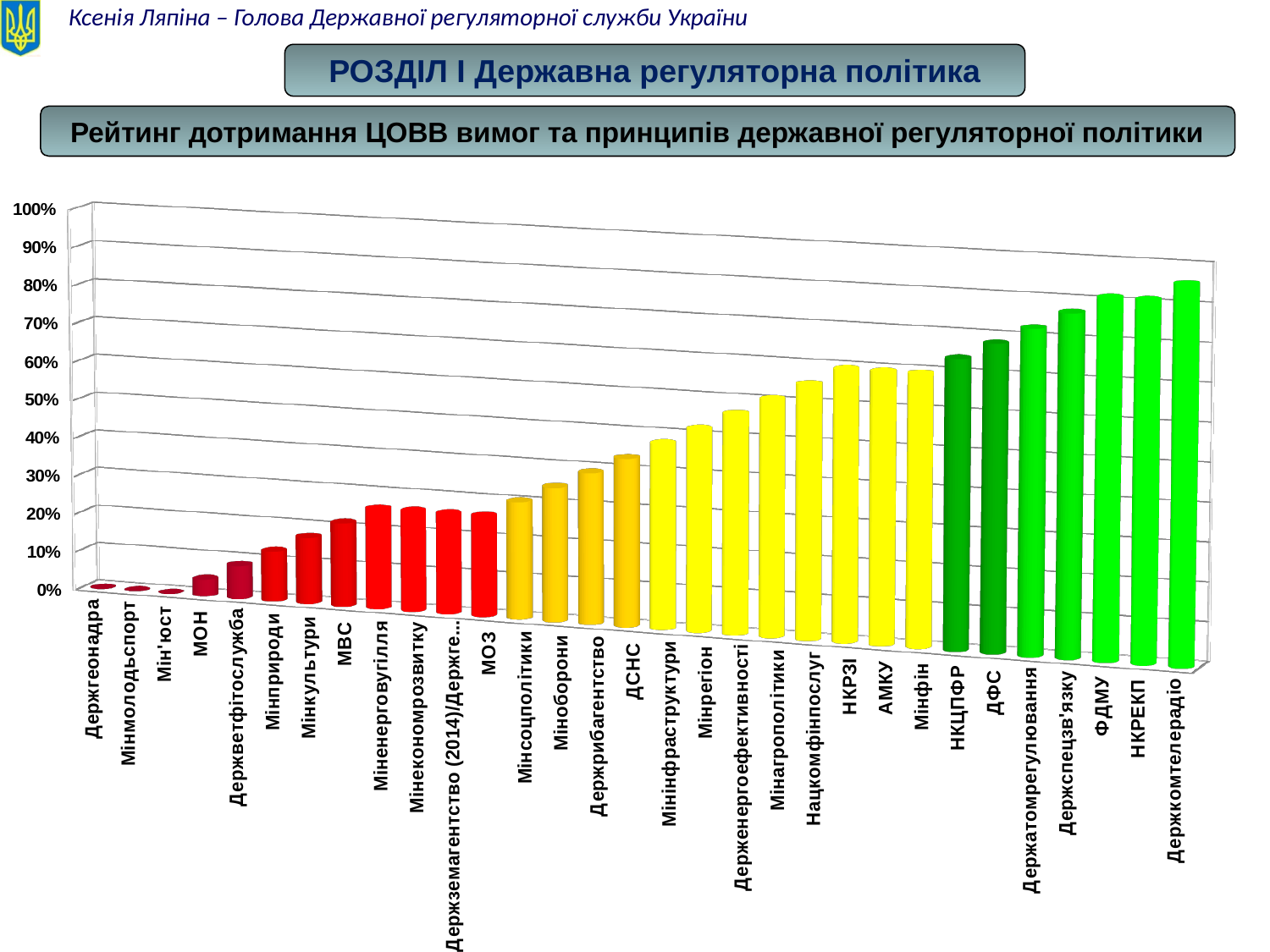
Which category has the highest value in the chart? Держкомтелерадіо Which has the larger value, Мінрегіон or Міноборони? Мінрегіон How many categories (bars) are shown in the chart? 31 Do the values generally rise or fall moving from left to right along the x axis? Rise Is the value for Мінфін greater or less than 50%? greater Is the value for МОН greater or less than 10%? less What kind of chart is shown on the slide? Bar chart Is the value for Держкомтелерадіо greater or less than 70%? greater What is the title of the chart on the slide? Рейтинг дотримання ЦОВВ вимог та принципів державної регуляторної політики